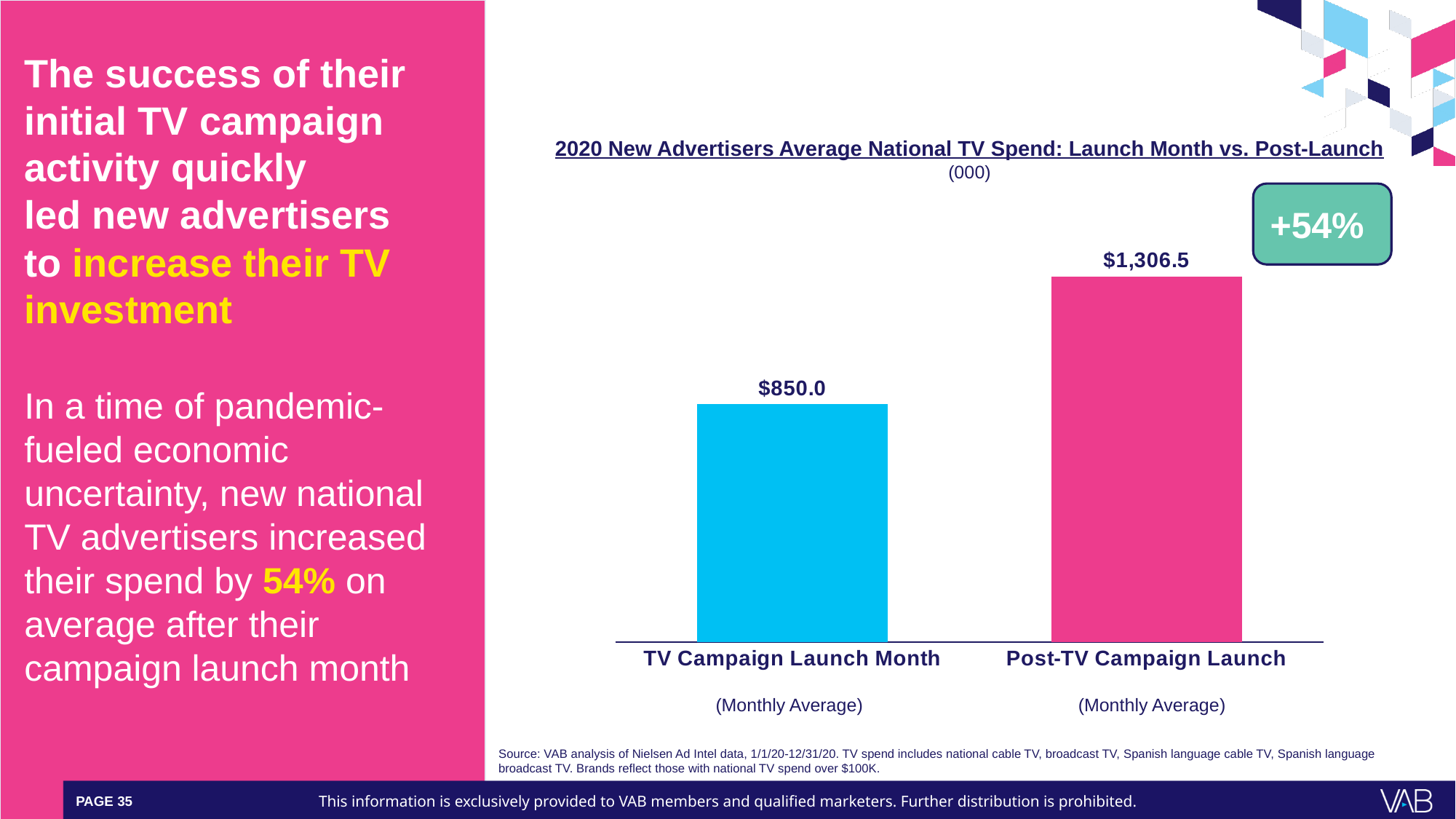
Which category has the highest value? Post-TV Campaign Launch Do the values rise or fall from TV Campaign Launch Month to Post-TV Campaign Launch? Rise Which is larger, the value for TV Campaign Launch Month or the value for Post-TV Campaign Launch? Post-TV Campaign Launch What percentage change is shown in the callout next to the chart? +54% What is the value for TV Campaign Launch Month? $850.0 What is the title of the chart? 2020 New Advertisers Average National TV Spend: Launch Month vs. Post-Launch What kind of chart is shown on the slide? Bar chart Which category has the lowest value? TV Campaign Launch Month What is the value for Post-TV Campaign Launch? $1,306.5 How many categories are shown in the chart? 2 What is the difference between the Post-TV Campaign Launch value and the TV Campaign Launch Month value? $456.5